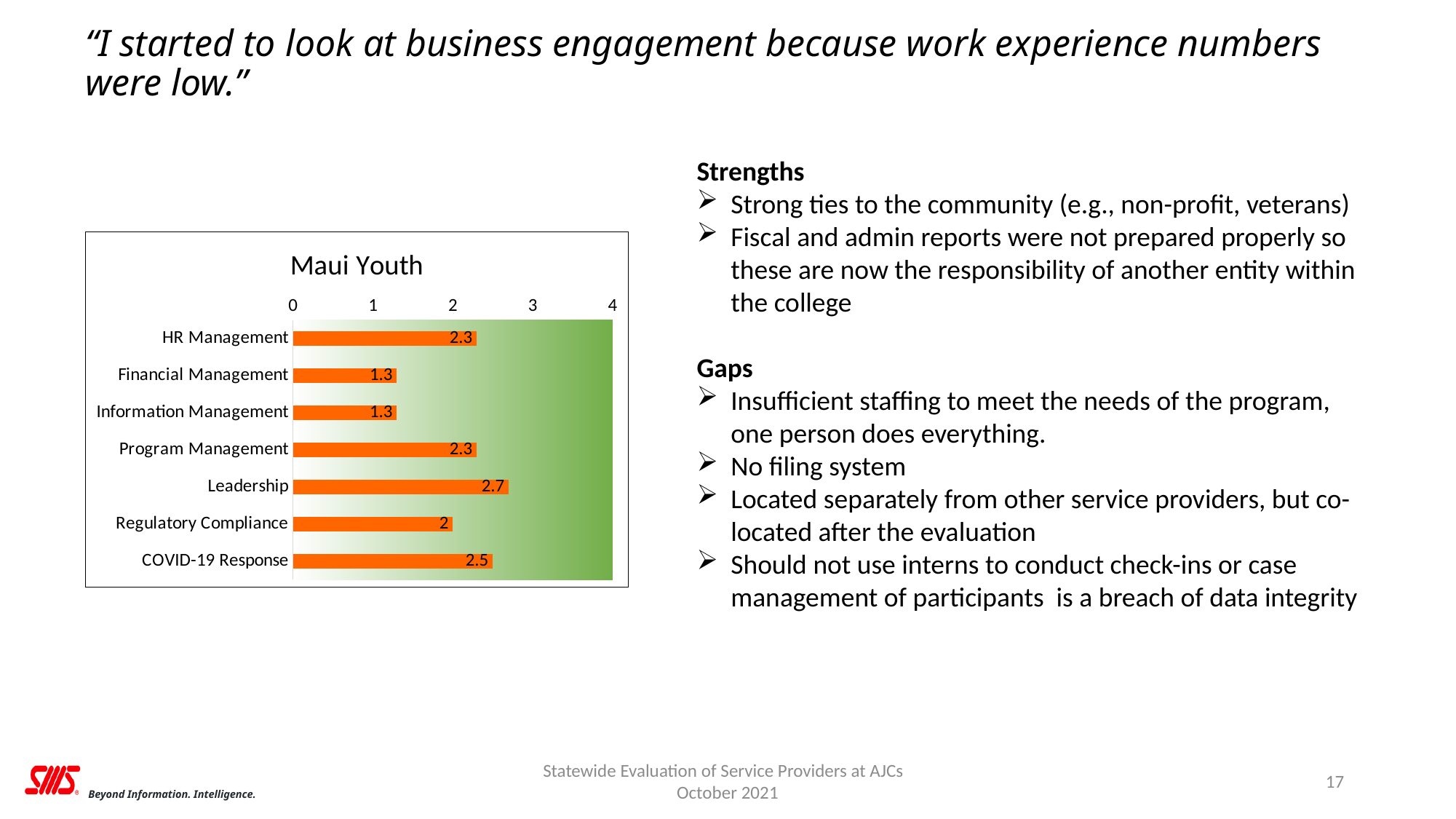
What is the maximum value shown on the axis of the Maui Youth chart? 4 What is the difference between the Leadership value and the Financial Management value in the Maui Youth chart? 1.4 Which category has the highest value in the Maui Youth chart? Leadership What kind of chart is the Maui Youth chart? bar chart Is the value for HR Management in the Maui Youth chart greater or less than 3? less What is the value for COVID-19 Response in the Maui Youth chart? 2.5 What is the value for Leadership in the Maui Youth chart? 2.7 What is the title of the chart on the slide? Maui Youth What is the difference between the HR Management value and the Regulatory Compliance value in the Maui Youth chart? 0.3 How many categories are shown in the Maui Youth chart? 7 What is the value for Regulatory Compliance in the Maui Youth chart? 2 Which is larger in the Maui Youth chart, COVID-19 Response or Program Management? COVID-19 Response